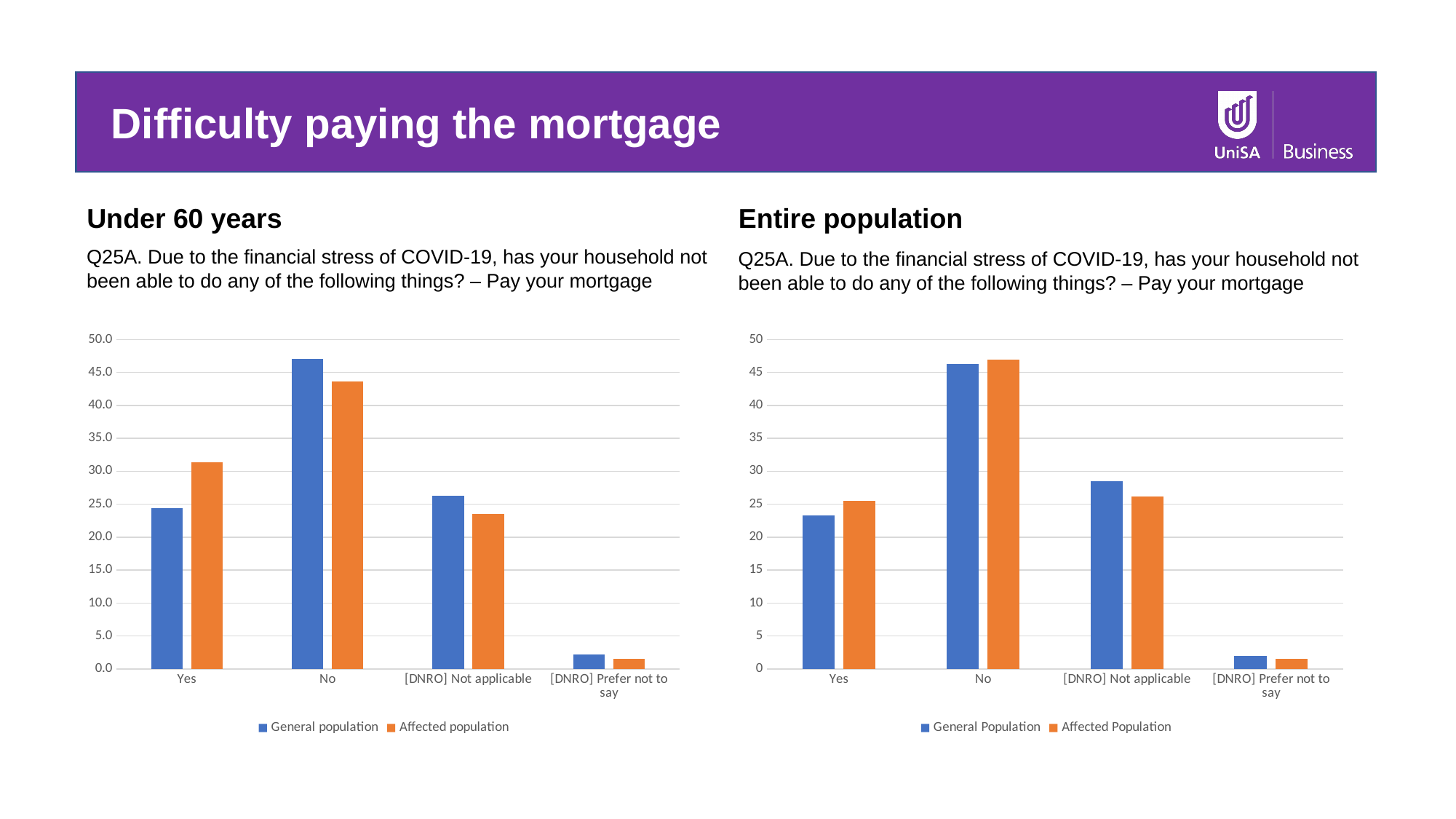
On the 'Under 60 years' chart, for 'Yes', which is larger: General population or Affected population? Affected population On the 'Under 60 years' chart, what kind of chart is shown? bar chart On the 'Under 60 years' chart, which category has the lowest value for Affected population? [DNRO] Prefer not to say On the 'Entire population' chart, for '[DNRO] Not applicable', which is larger: General Population or Affected Population? General Population On the 'Under 60 years' chart, how many series does the legend list? 2 On the 'Under 60 years' chart, which category has the highest value for General population? No On the 'Under 60 years' chart, is the Affected population value for 'Yes' greater or less than 30.0? greater On the 'Entire population' chart, which category has the highest value for Affected Population? No On the 'Entire population' chart, is the General Population value for 'Yes' greater or less than 25? less On the 'Under 60 years' chart, is the General population value for 'No' greater or less than 45.0? greater On the 'Entire population' chart, what are the two series listed in the legend? General Population and Affected Population On the 'Under 60 years' chart, how many response categories are shown on the x axis? 4